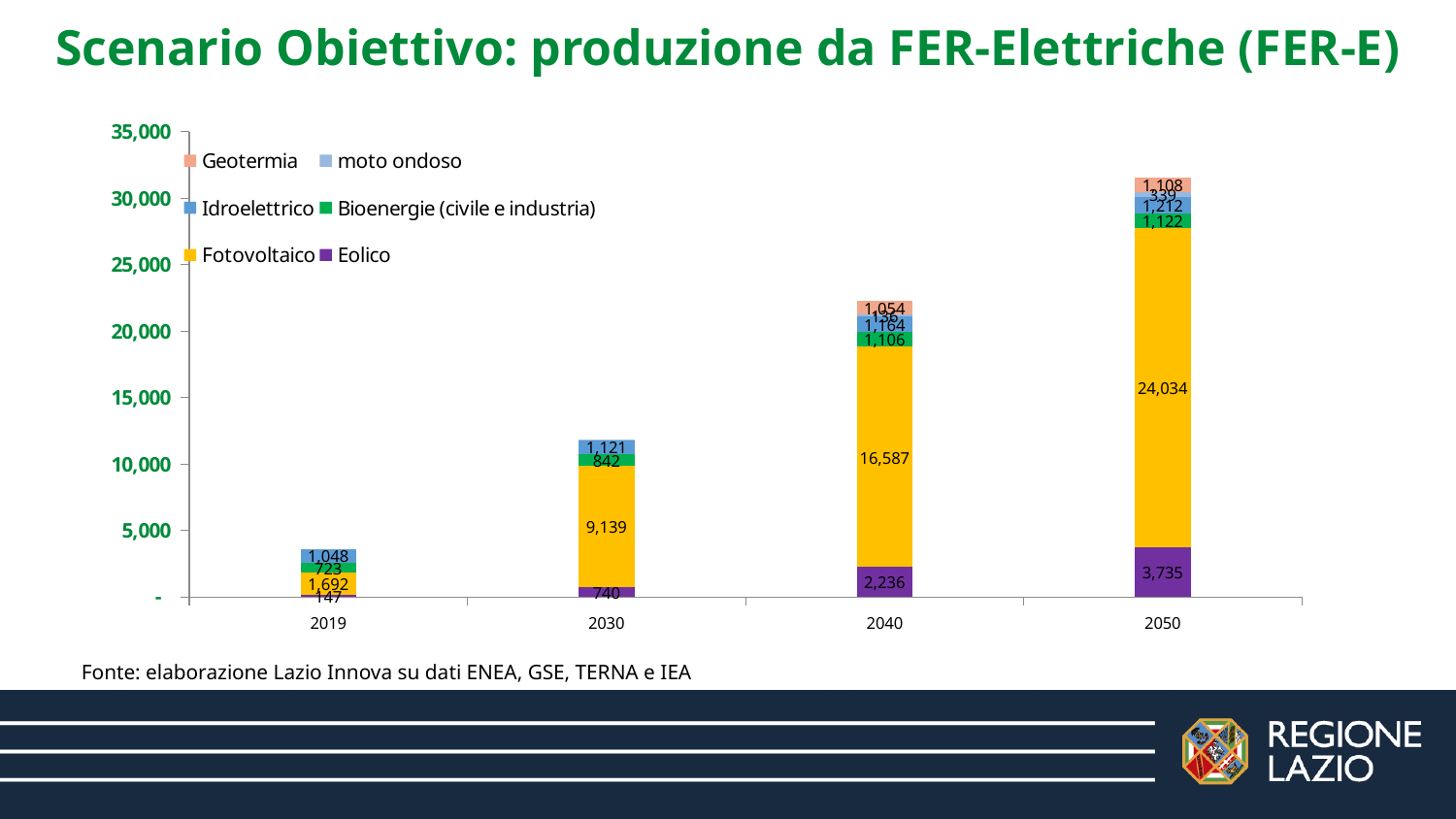
How many series does the legend list? 6 Is the total height of the 2050 stacked bar greater or less than 30,000? greater What is the difference between the Fotovoltaico values for 2050 and 2040? 7,447 What is the Eolico value for 2040? 2,236 Does the Eolico value rise or fall from 2019 to 2050? rise What is the Bioenergie (civile e industria) value for 2030? 842 What is the Fotovoltaico value for 2050? 24,034 What is the Fotovoltaico value for 2030? 9,139 What is the Idroelettrico value for 2019? 1,048 Which year has the highest Fotovoltaico value? 2050 How many years are shown on the x axis? 4 Which is larger in 2030, Fotovoltaico or Eolico? Fotovoltaico